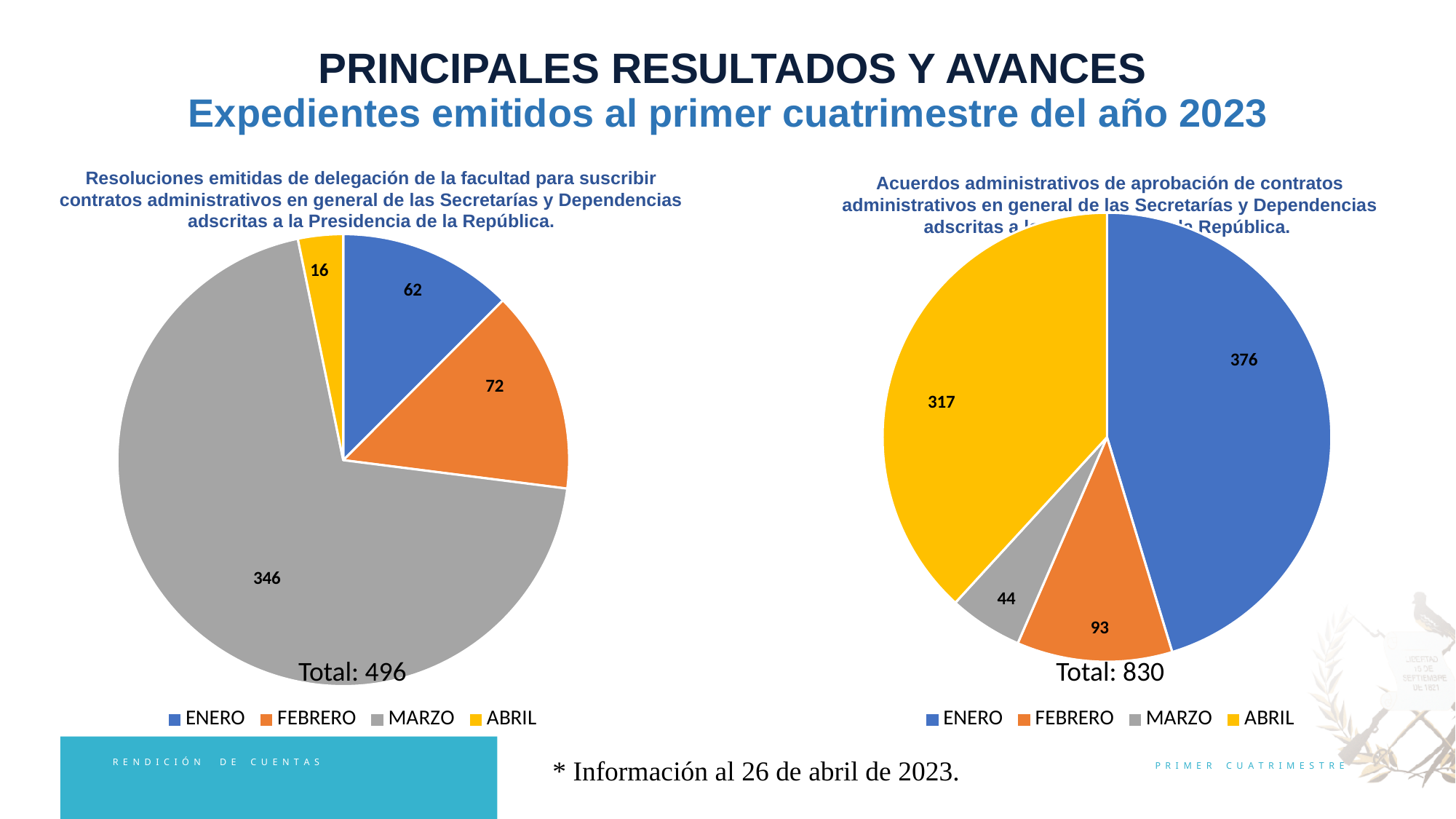
In the left pie chart (Resoluciones emitidas), what is the value for MARZO? 346 In the right pie chart (Acuerdos administrativos), what is the difference between the values for ENERO and ABRIL? 59 In the right pie chart (Acuerdos administrativos), which is larger, FEBRERO or MARZO? FEBRERO In the left pie chart (Resoluciones emitidas), what is the difference between the values for FEBRERO and ENERO? 10 What type of chart is used on the left side of the slide? Pie chart In the right pie chart (Acuerdos administrativos), what is the value for ENERO? 376 In the left pie chart (Resoluciones emitidas), which month has the largest slice? MARZO What is the total shown for the right pie chart (Acuerdos administrativos)? 830 In the right pie chart (Acuerdos administrativos), what is the value for MARZO? 44 How many series does the legend of the left pie chart list? 4 In the right pie chart (Acuerdos administrativos), which month has the smallest slice? MARZO In the left pie chart (Resoluciones emitidas), what is the value for ABRIL? 16